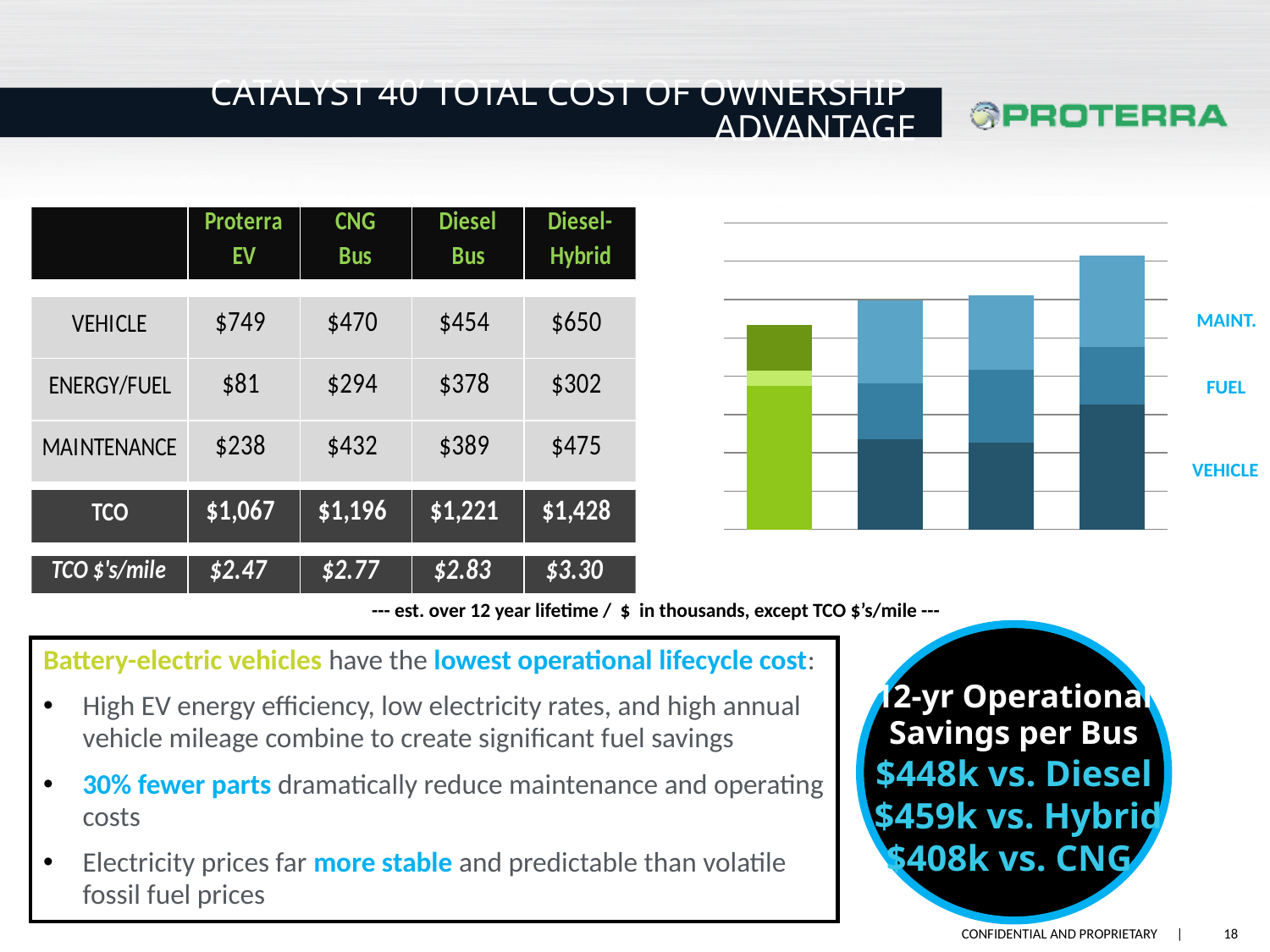
How many bars are plotted in the bar chart? 4 Which bar in the bar chart is the shortest? the leftmost (first) bar What kind of chart is shown on the right side of the slide? bar chart Which bar in the bar chart is the tallest? the rightmost (fourth) bar In the bar chart, is the leftmost bar or the rightmost bar taller? the rightmost bar What are the three legend entries of the bar chart? MAINT., FUEL, VEHICLE How many series does the legend of the bar chart list? 3 Which series forms the bottom segment of each stacked bar in the chart? VEHICLE Do the total bar heights in the bar chart generally rise or fall from left to right? rise